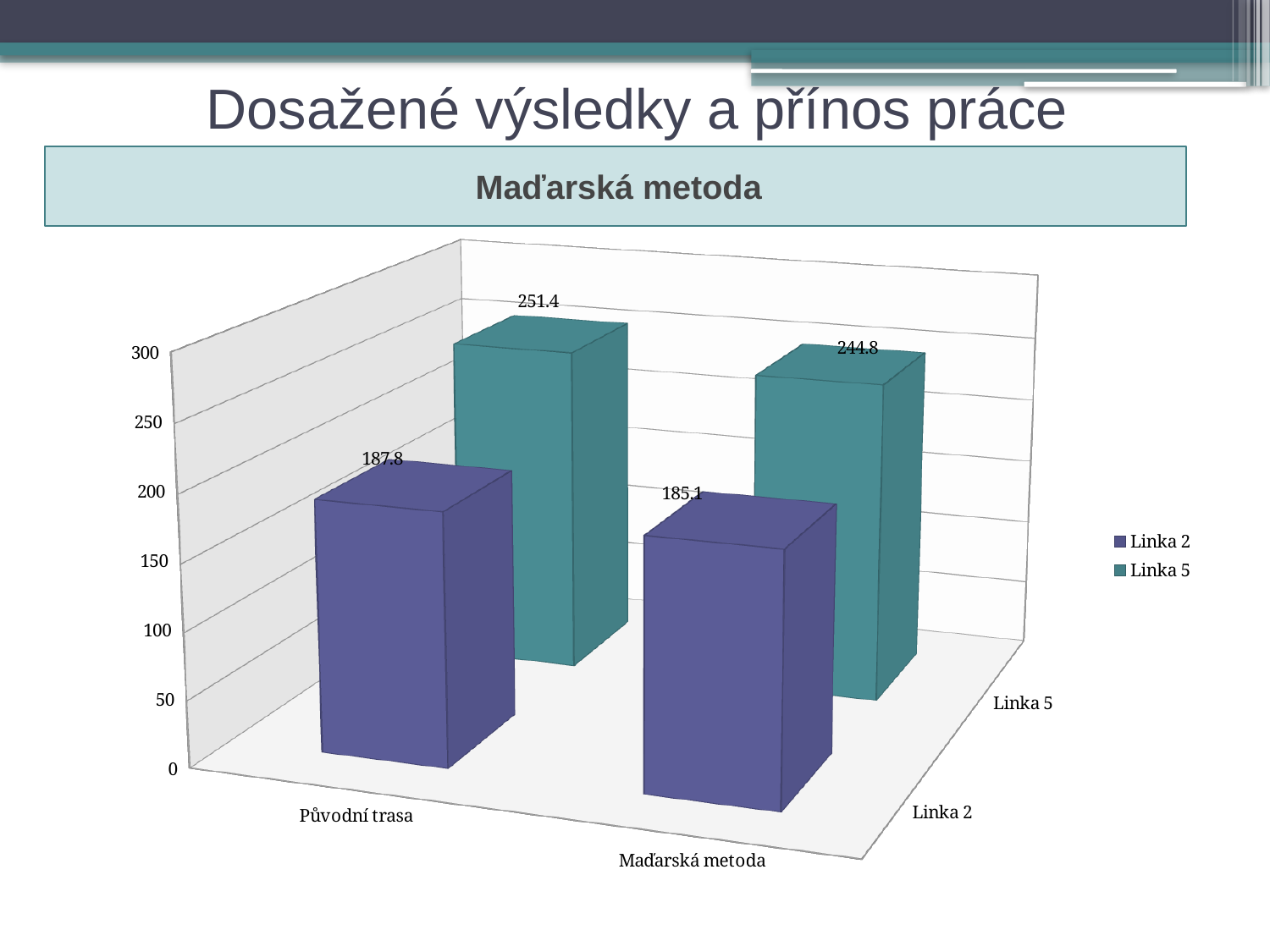
What kind of chart is shown on the slide? Bar chart Which bar has the highest value on the chart? Linka 5, Původní trasa What is the value for Linka 5 in the Původní trasa category? 251.4 What is the value for Linka 2 in the Původní trasa category? 187.8 What is the value for Linka 2 in the Maďarská metoda category? 185.1 What is the value for Linka 5 in the Maďarská metoda category? 244.8 What is the difference between the Linka 5 values for Původní trasa and Maďarská metoda? 6.6 Which is larger in the Maďarská metoda category: Linka 2 or Linka 5? Linka 5 How many categories are shown on the x axis? 2 Which bar has the lowest value on the chart? Linka 2, Maďarská metoda How many series does the legend list? 2 What is the difference between the Linka 5 and Linka 2 values in the Původní trasa category? 63.6